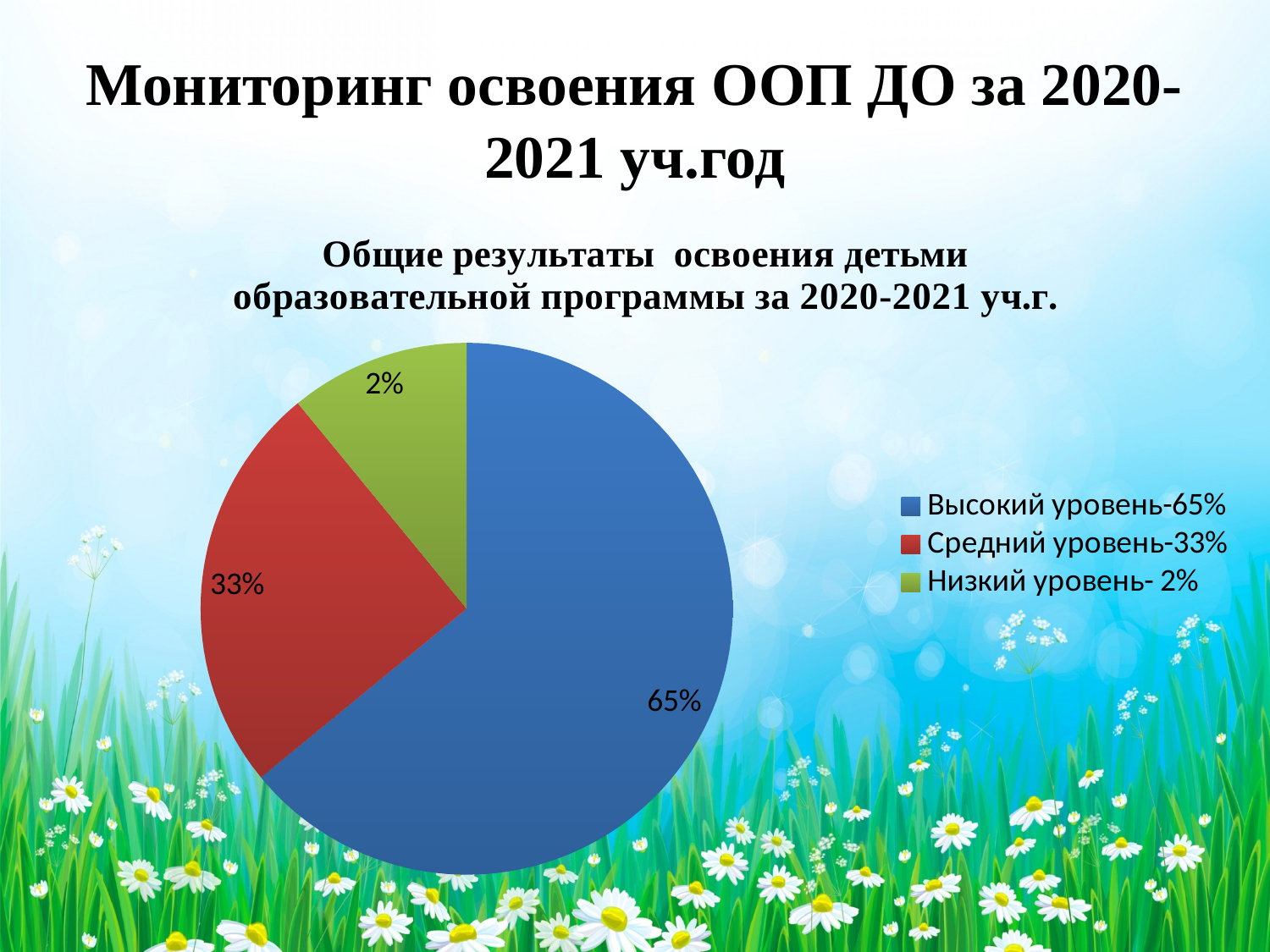
What is the value for Средний уровень? 33% What is the value for Высокий уровень? 65% What is the difference between the values for Высокий уровень and Средний уровень? 32% Which category has the largest slice of the pie? Высокий уровень What is the title of the chart? Общие результаты освоения детьми образовательной программы за 2020-2021 уч.г. What colour is the slice for Высокий уровень? blue What is the value for Низкий уровень? 2% How many slices does the pie chart have? 3 Which is larger, the value for Средний уровень or the value for Низкий уровень? Средний уровень Which category has the smallest slice of the pie? Низкий уровень What is the difference between the values for Средний уровень and Низкий уровень? 31% What kind of chart is shown on the slide? pie chart